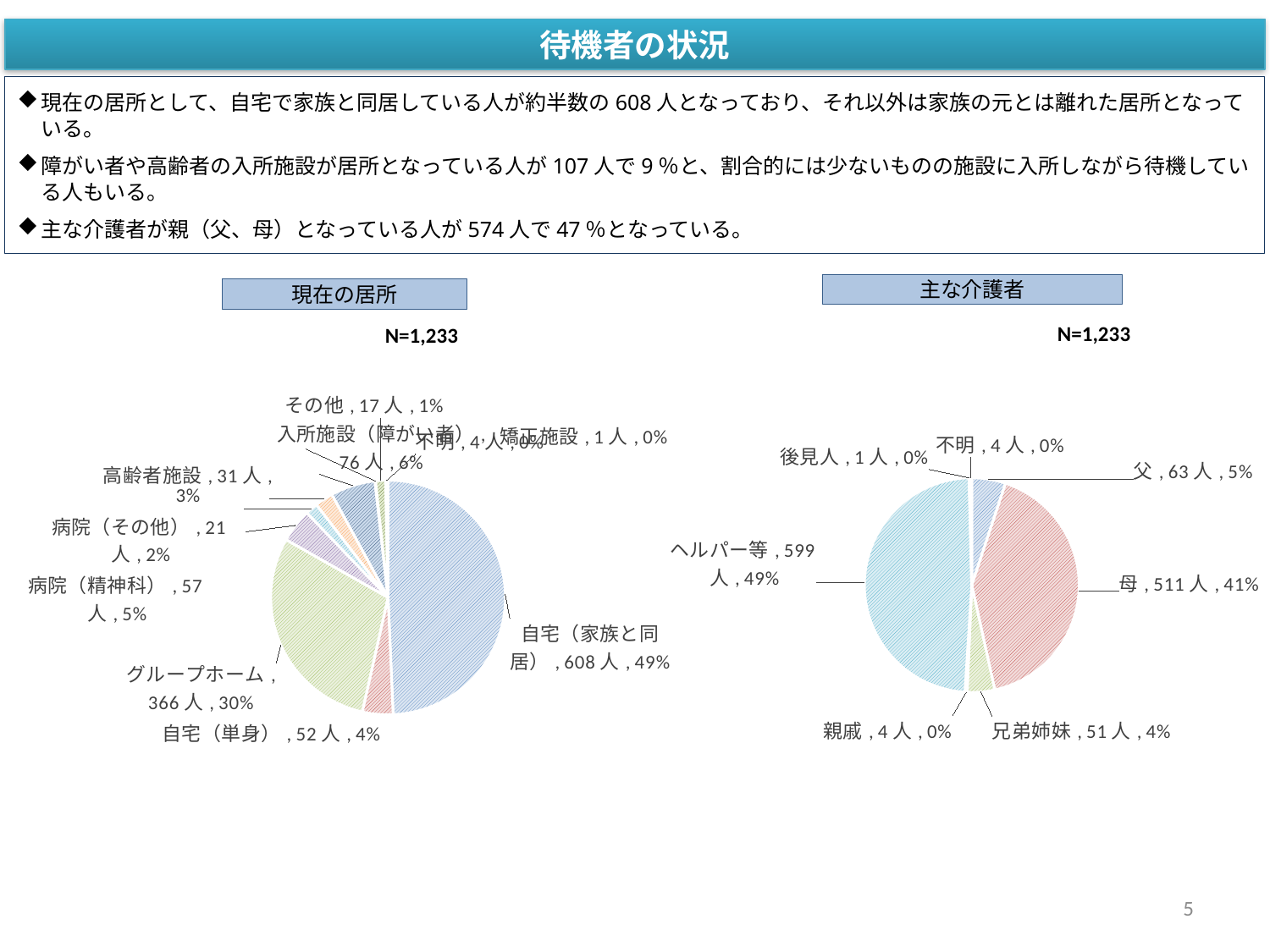
In the 主な介護者 chart, which category has the smallest slice? 後見人 In the 主な介護者 chart, what share of the pie is 母? 41% In the 現在の居所 chart, how many people live in 自宅（家族と同居）? 608 人 In the 主な介護者 chart, how many categories are shown? 7 In the 現在の居所 chart, which is larger, 病院（精神科） or 自宅（単身）? 病院（精神科） What type of chart is used for 現在の居所? pie chart In the 主な介護者 chart, how many people have ヘルパー等 as their main caregiver? 599 人 In the 主な介護者 chart, what is the combined number of people for 父 and 母? 574 人 In the 現在の居所 chart, what share of the pie is グループホーム? 30% What is the N value shown for the 主な介護者 chart? N=1,233 In the 現在の居所 chart, what is the difference in people between 入所施設（障がい者） and 高齢者施設? 45 人 In the 現在の居所 chart, which category has the largest slice? 自宅（家族と同居）